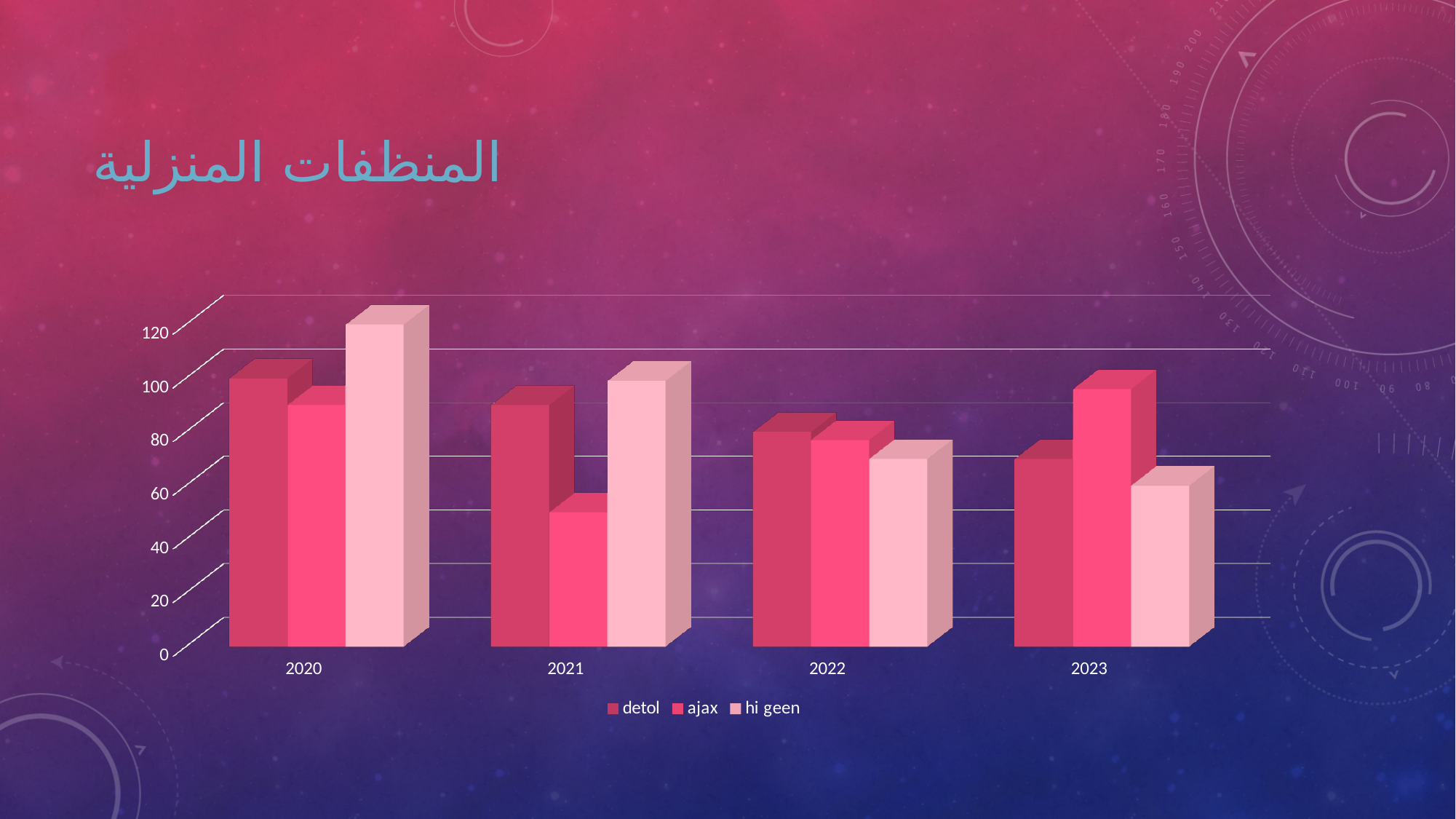
Is the value for ajax in 2021 greater or less than 60? less Which series has the tallest bar in 2020? hi geen Which series has the tallest bar in 2023? ajax What kind of chart is shown on the slide? bar chart How many series does the legend list? 3 Do the values for detol rise or fall from 2020 to 2023? fall Which series has the shortest bar in 2021? ajax How many year categories are shown on the x axis? 4 What are the three series names listed in the legend? detol, ajax, hi geen Is the value for hi geen in 2020 greater or less than 100? greater Which is larger: hi geen in 2020 or ajax in 2021? hi geen in 2020 Is the value for hi geen in 2023 greater or less than 80? less